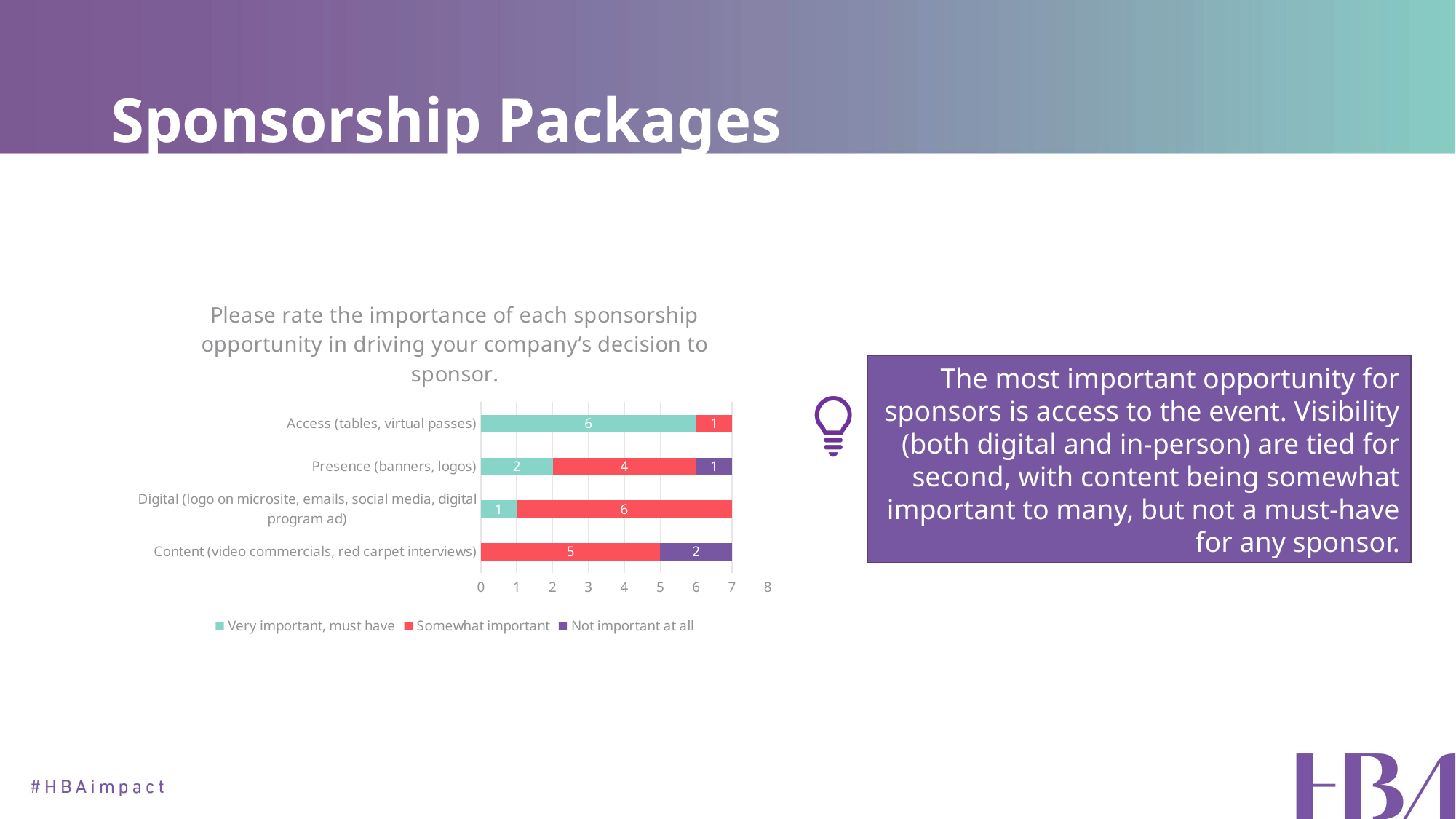
What is the difference between the 'Very important, must have' values for Access (tables, virtual passes) and Presence (banners, logos)? 4 What is the 'Not important at all' value for Content (video commercials, red carpet interviews)? 2 Which category has the highest 'Very important, must have' value? Access (tables, virtual passes) How many series does the chart legend list? 3 What is the 'Somewhat important' value for Presence (banners, logos)? 4 What is the 'Very important, must have' value for Access (tables, virtual passes)? 6 What is the total of the stacked bar for Presence (banners, logos)? 7 What is the 'Somewhat important' value for Digital (logo on microsite, emails, social media, digital program ad)? 6 Which is larger: the 'Somewhat important' value for Content (video commercials, red carpet interviews) or for Presence (banners, logos)? Content (video commercials, red carpet interviews) How many sponsorship opportunities (categories) are plotted in the chart? 4 What type of chart is shown on the slide? Stacked bar chart Which category has the highest 'Not important at all' value? Content (video commercials, red carpet interviews)